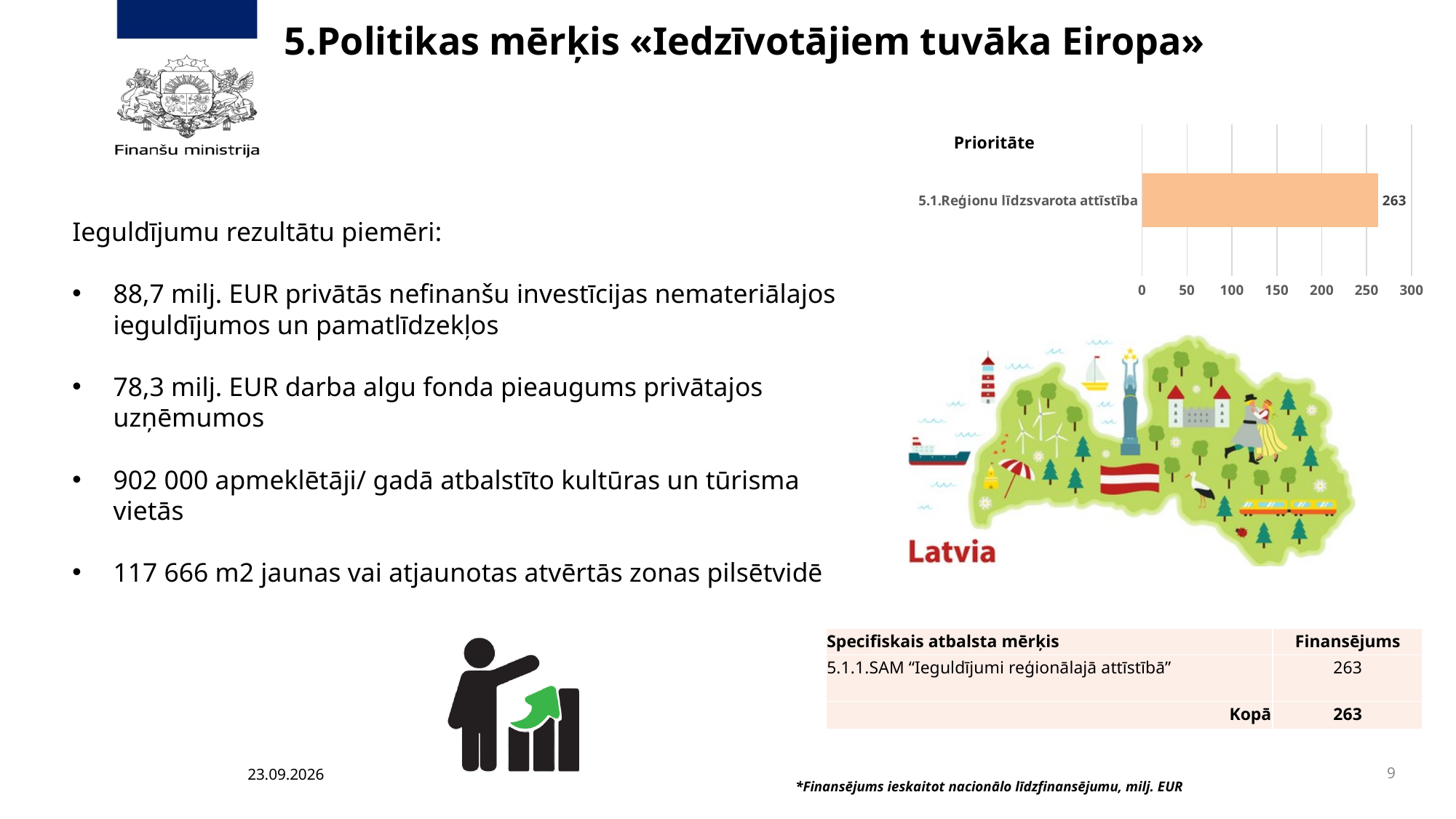
Is the value for 5.1.Reģionu līdzsvarota attīstība greater or less than 250? greater How many categories are plotted in the chart? 1 Is the value for 5.1.Reģionu līdzsvarota attīstība greater or less than 300? less What is the highest value shown on the chart's horizontal axis? 300 Which category has the highest value in the chart? 5.1.Reģionu līdzsvarota attīstība What is the value shown for 5.1.Reģionu līdzsvarota attīstība in the chart? 263 What kind of chart is shown on the slide? bar chart What is the title of the chart? Prioritāte